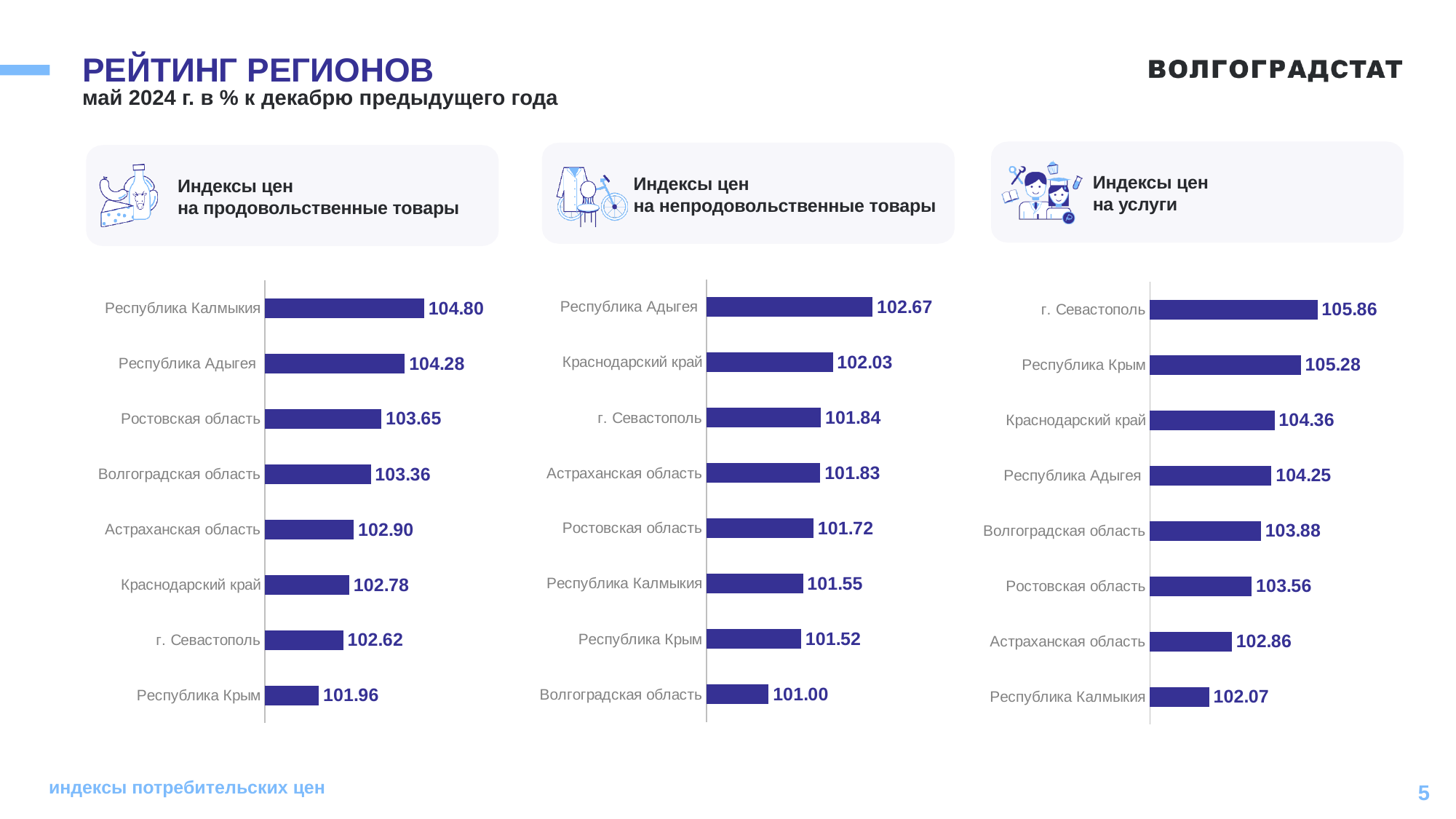
What type of chart is used for 'Индексы цен на продовольственные товары'? Bar chart In the chart 'Индексы цен на продовольственные товары', which region has the highest value? Республика Калмыкия In the chart 'Индексы цен на непродовольственные товары', what is the value for Астраханская область? 101.83 How many regions are shown in the chart 'Индексы цен на услуги'? 8 In the chart 'Индексы цен на непродовольственные товары', which region has the lowest value? Волгоградская область In the chart 'Индексы цен на услуги', what is the value for Республика Крым? 105.28 In the chart 'Индексы цен на услуги', what is the difference between the values for г. Севастополь and Республика Калмыкия? 3.79 In the chart 'Индексы цен на услуги', which region has the highest value? г. Севастополь How many charts are shown on the slide? 3 In the chart 'Индексы цен на продовольственные товары', what is the difference between the values for Республика Калмыкия and Республика Крым? 2.84 In the chart 'Индексы цен на непродовольственные товары', which is larger: the value for Краснодарский край or the value for Республика Калмыкия? Краснодарский край In the chart 'Индексы цен на продовольственные товары', what is the value for Волгоградская область? 103.36